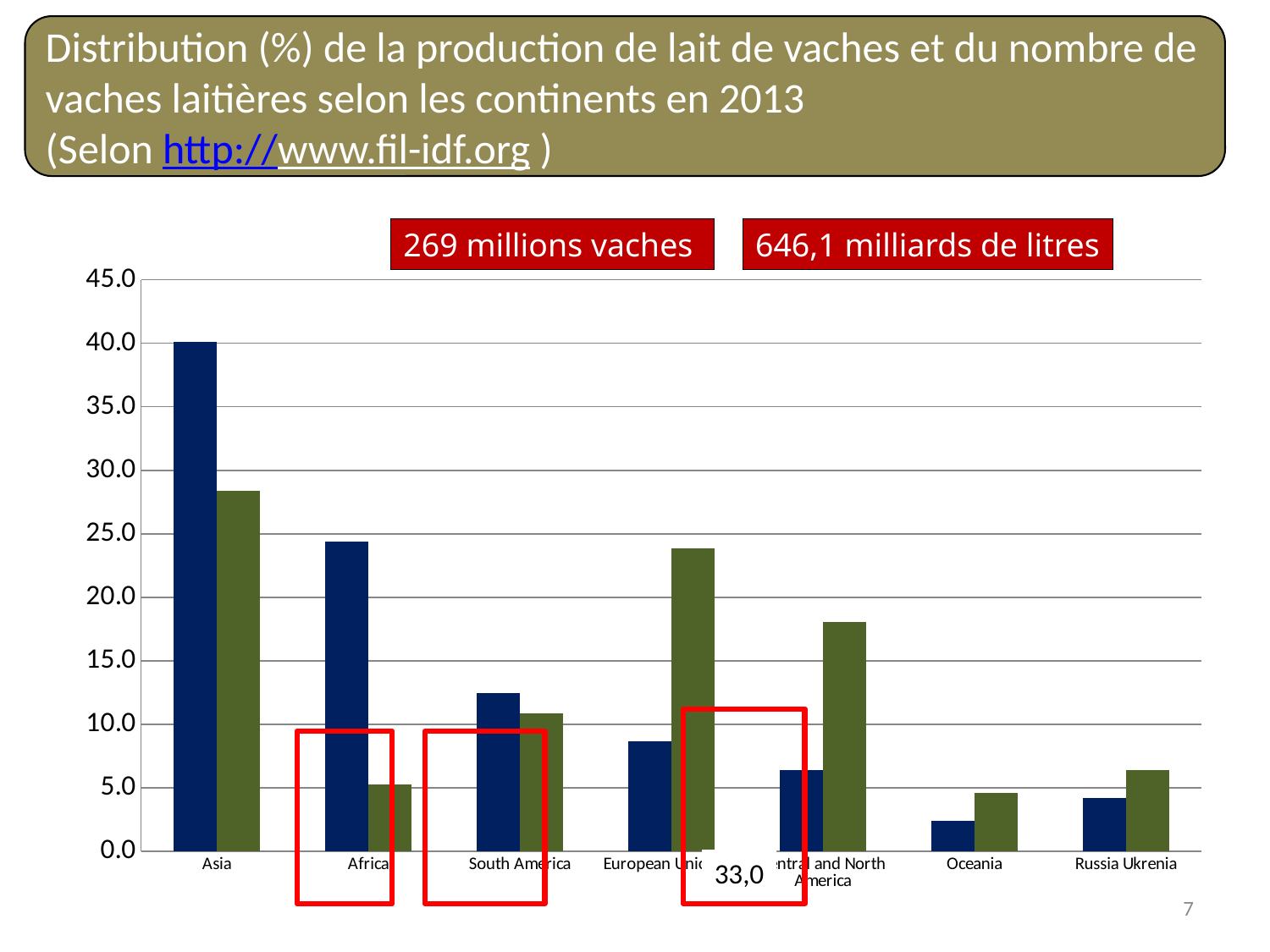
Is the dark blue bar for Asia greater or less than 35.0? greater For Africa, which bar is taller, the dark blue one or the green one? the dark blue one Is the dark blue bar for Oceania greater or less than 5.0? less For European Union, which bar is taller, the dark blue one or the green one? the green one Is the green bar for European Union greater or less than 20.0? greater Which category has the tallest dark blue bar? Asia What total number of dairy cows is stated in the red box above the chart? 269 millions vaches What kind of chart is shown on the slide? bar chart Which category has the tallest green bar? Asia How many continent/region categories are shown on the x axis of the chart? 7 Which category has the shortest dark blue bar? Oceania